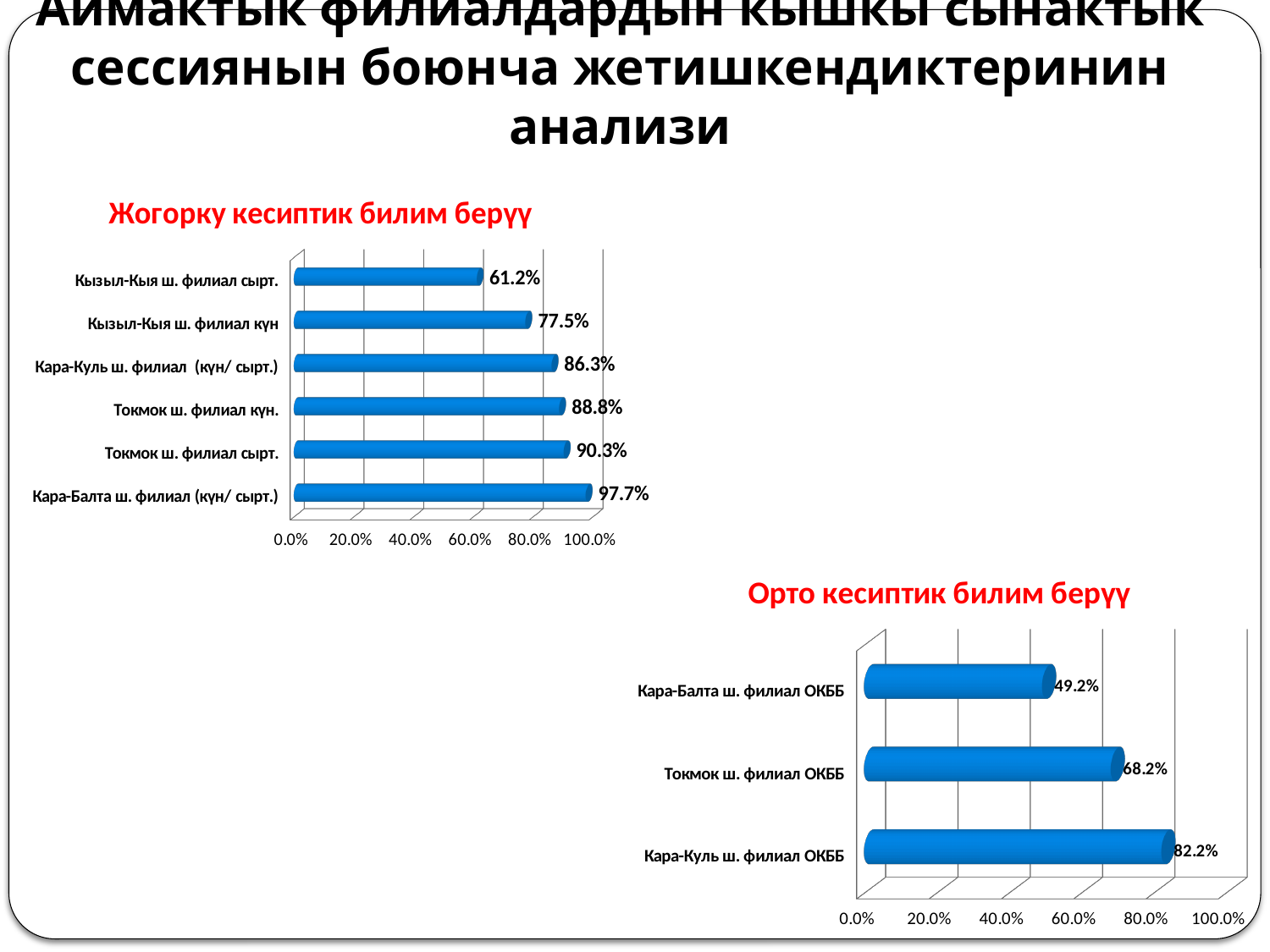
In the 'Орто кесиптик билим берүү' chart, what is the value for Токмок ш. филиал ОКББ? 68.2% In the 'Жогорку кесиптик билим берүү' chart, what is the difference between Токмок ш. филиал сырт. and Токмок ш. филиал күн.? 1.5% What kind of chart is the 'Орто кесиптик билим берүү' chart? bar chart In the 'Орто кесиптик билим берүү' chart, what is the difference between Кара-Куль ш. филиал ОКББ and Кара-Балта ш. филиал ОКББ? 33.0% In the 'Жогорку кесиптик билим берүү' chart, how many categories are plotted? 6 In the 'Жогорку кесиптик билим берүү' chart, which category has the highest value? Кара-Балта ш. филиал (күн/ сырт.) In the 'Орто кесиптик билим берүү' chart, which category has the highest value? Кара-Куль ш. филиал ОКББ In the 'Орто кесиптик билим берүү' chart, is the value for Кара-Балта ш. филиал ОКББ greater or less than 60.0%? less In the 'Орто кесиптик билим берүү' chart, how many categories are plotted? 3 In the 'Жогорку кесиптик билим берүү' chart, which category has the lowest value? Кызыл-Кыя ш. филиал сырт. In the 'Жогорку кесиптик билим берүү' chart, what is the value for Кара-Балта ш. филиал (күн/ сырт.)? 97.7% In the 'Жогорку кесиптик билим берүү' chart, what is the value for Кызыл-Кыя ш. филиал күн? 77.5%